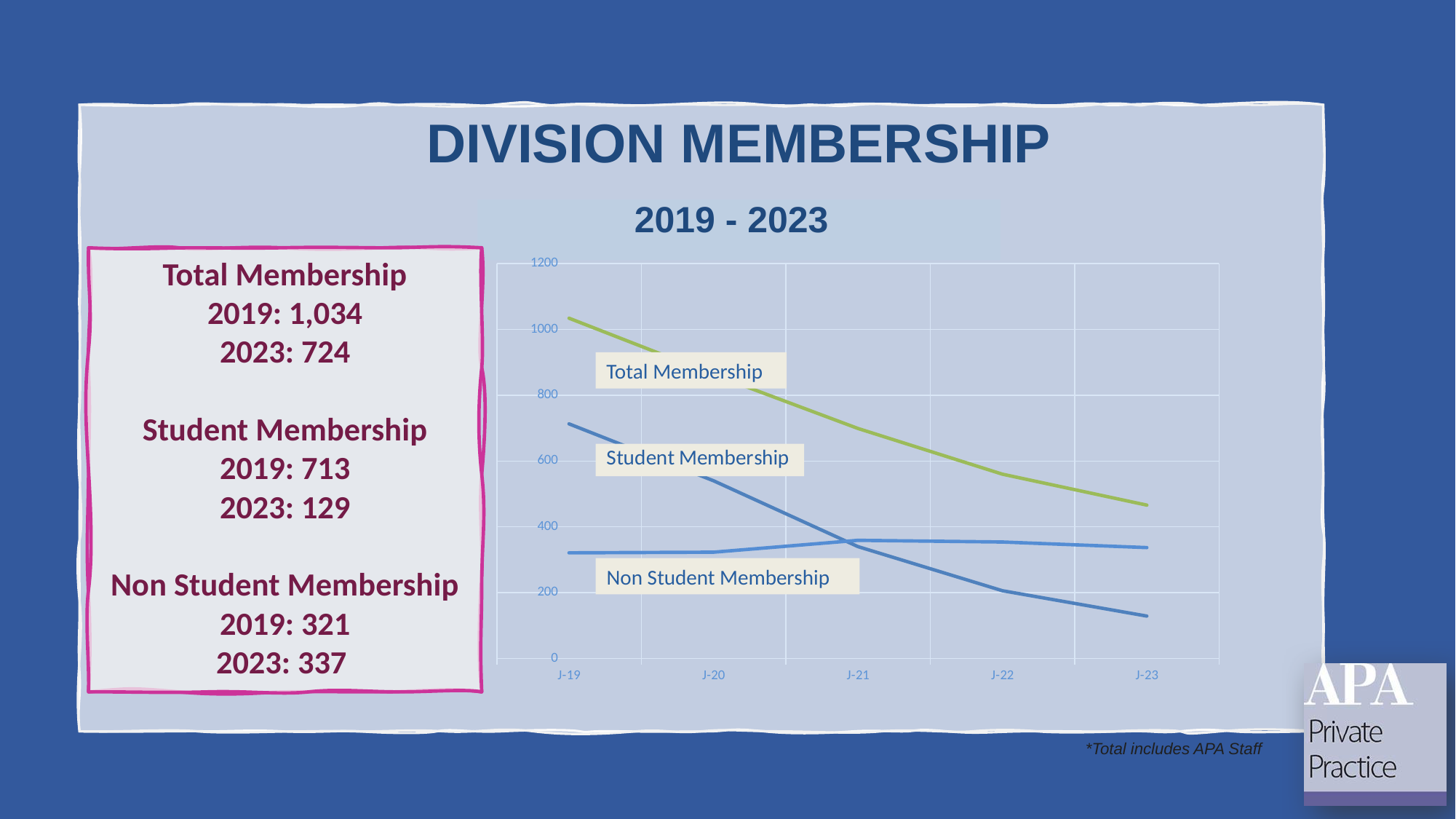
How many points along the x axis does the chart show? 5 What was Non Student Membership in 2019? 321 What was Total Membership in 2019? 1,034 How many series are plotted on the chart? 3 Which series has the lowest value at J-23? Student Membership What was Total Membership in 2023? 724 By how much did Student Membership fall from 2019 to 2023? 584 Does the Student Membership line rise or fall from J-19 to J-23? fall What kind of chart is shown on the slide? line chart What was Student Membership in 2023? 129 Is the Total Membership value at J-21 greater or less than 800? less By how much did Total Membership fall from 2019 to 2023? 310